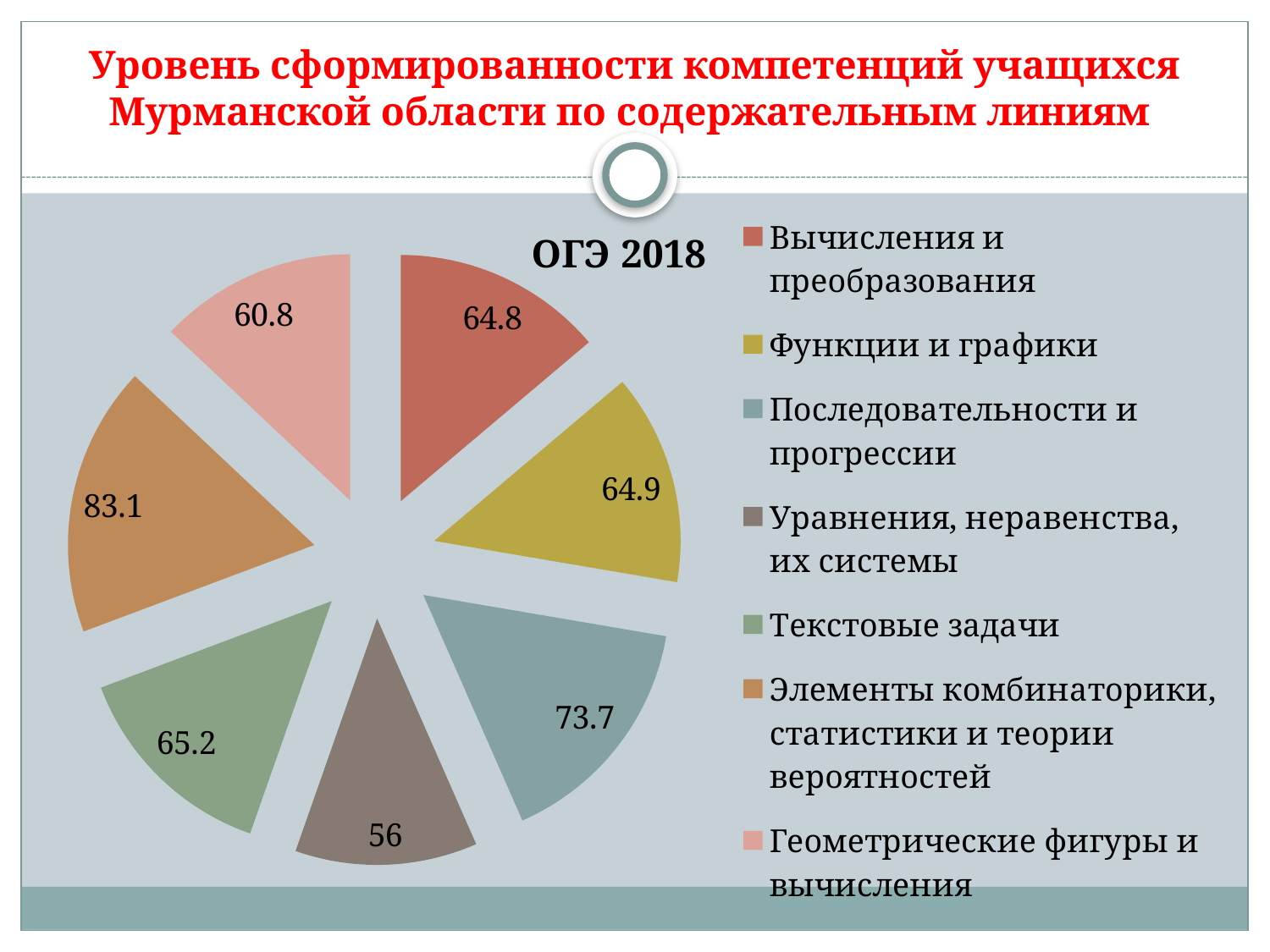
How many slices does the pie chart have? 7 What kind of chart is shown on the slide? pie chart What is the value for Уравнения, неравенства, их системы? 56 Which is larger: the value for Последовательности и прогрессии or the value for Геометрические фигуры и вычисления? Последовательности и прогрессии What is the value for Функции и графики? 64.9 What is the title of the chart? ОГЭ 2018 What is the difference between the values for Элементы комбинаторики, статистики и теории вероятностей and Текстовые задачи? 17.9 What is the value for Вычисления и преобразования? 64.8 Which category has the lowest value? Уравнения, неравенства, их системы Which category has the highest value? Элементы комбинаторики, статистики и теории вероятностей What is the value for Последовательности и прогрессии? 73.7 What is the value for Геометрические фигуры и вычисления? 60.8